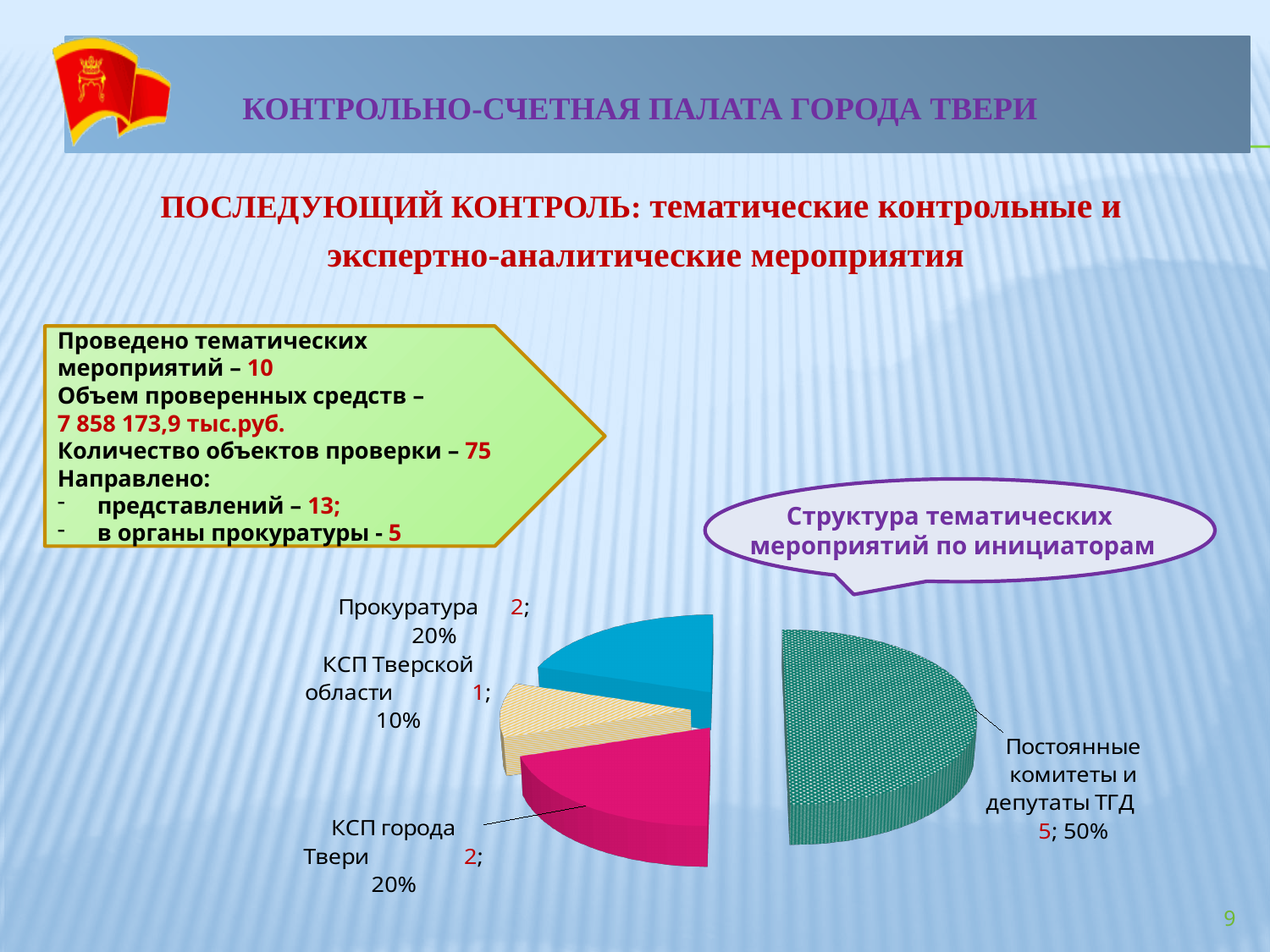
What is the value for КСП города Твери in the pie chart? 2 What share of the pie does Постоянные комитеты и депутаты ТГД represent? 50% Which category has the smallest slice in the pie chart? КСП Тверской области What share of the pie does Прокуратура represent? 20% What is the difference between the values for Постоянные комитеты и депутаты ТГД and Прокуратура? 3 What is the title shown in the callout above the pie chart? Структура тематических мероприятий по инициаторам Which is larger: the value for КСП города Твери or the value for КСП Тверской области? КСП города Твери What kind of chart is shown on the slide? pie chart Which category has the largest slice in the pie chart? Постоянные комитеты и депутаты ТГД What is the value for Постоянные комитеты и депутаты ТГД in the pie chart? 5 How many slices does the pie chart have? 4 What is the value for КСП Тверской области in the pie chart? 1